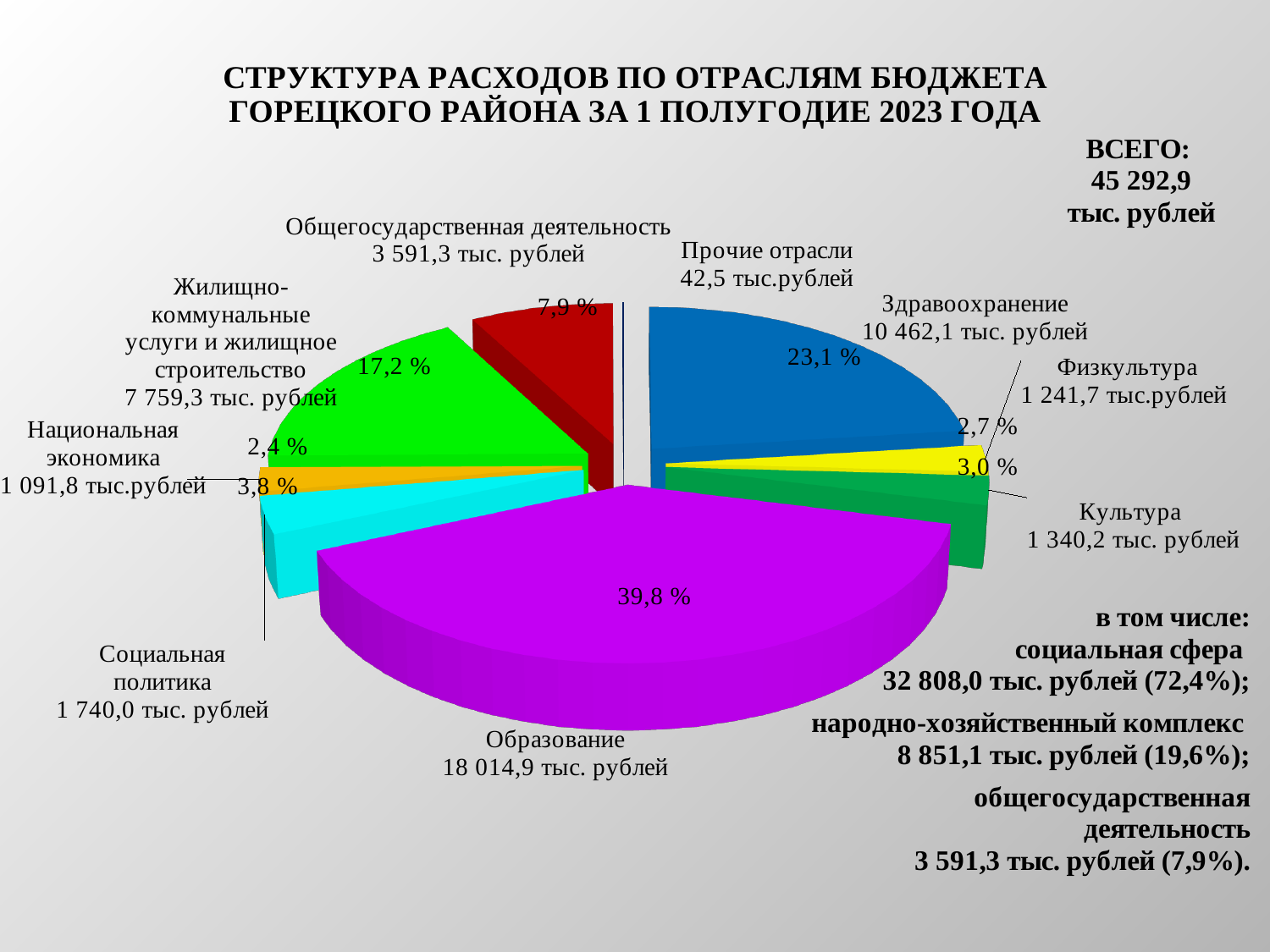
What kind of chart is shown on the slide? pie chart Which is larger, Культура or Физкультура? Культура What is the value for Здравоохранение? 10 462,1 тыс. рублей Which category has the smallest slice of the pie? Прочие отрасли What share of the pie does Социальная политика have? 3,8 % What share of the pie does Жилищно-коммунальные услуги и жилищное строительство have? 17,2 % How many categories (slices) does the pie chart show? 9 What colour is the slice for Образование? purple (magenta) Which category has the largest slice of the pie? Образование What is the difference between the values for Образование and Здравоохранение? 7 552,8 тыс. рублей What is the value for Образование? 18 014,9 тыс. рублей What is the total of all expenditures shown on the slide (ВСЕГО)? 45 292,9 тыс. рублей